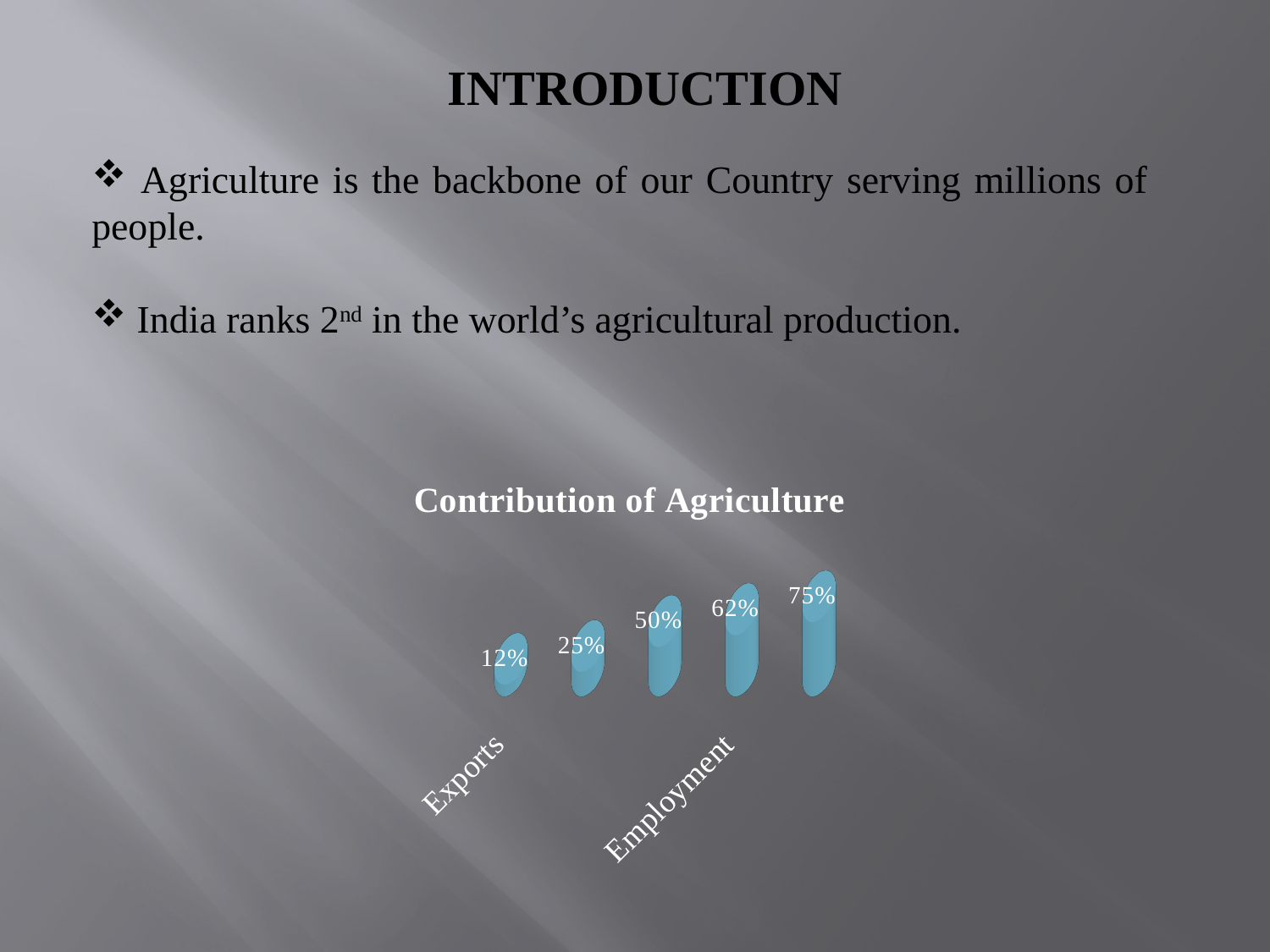
Which labelled category has the lowest value in the Contribution of Agriculture chart? Exports What is the value shown on the second bar from the left in the Contribution of Agriculture chart? 25% What is the value for Employment in the Contribution of Agriculture chart? 62% Do the values in the Contribution of Agriculture chart rise or fall from left to right? Rise What is the difference between the Employment and Exports values in the Contribution of Agriculture chart? 50% What kind of chart is the Contribution of Agriculture chart? Bar chart How many bars are plotted in the Contribution of Agriculture chart? 5 What is the title of the chart on the slide? Contribution of Agriculture What is the value shown on the rightmost bar of the Contribution of Agriculture chart? 75% What is the value for Exports in the Contribution of Agriculture chart? 12% Which is larger in the Contribution of Agriculture chart, Exports or Employment? Employment What is the highest value shown in the Contribution of Agriculture chart? 75%